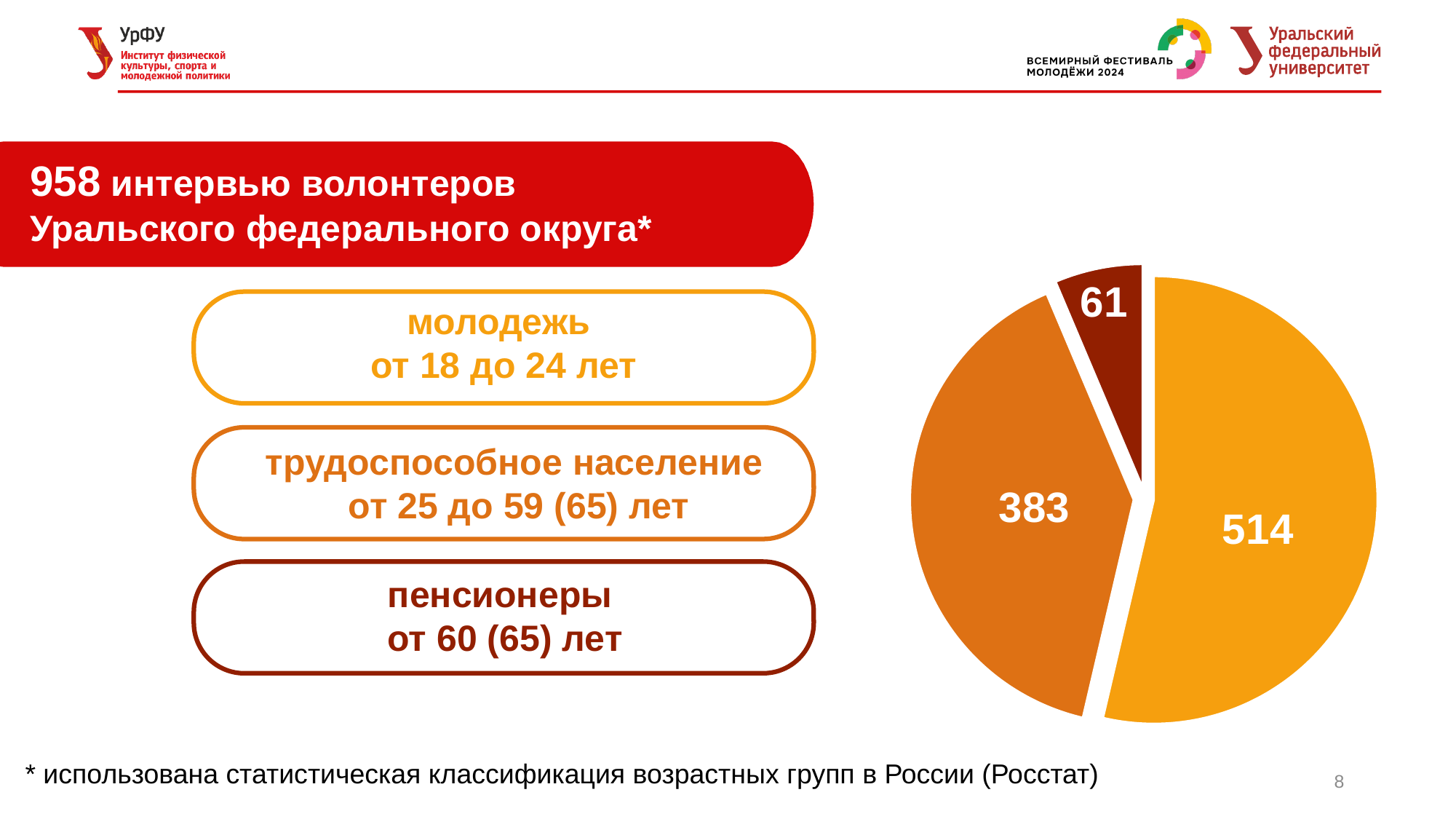
What is the value for молодежь от 18 до 24 лет in the pie chart? 514 Which age group has the largest slice in the pie chart? молодежь от 18 до 24 лет What is the total of all three slices in the pie chart? 958 What is the value for трудоспособное население от 25 до 59 (65) лет in the pie chart? 383 What colour is the slice for пенсионеры от 60 (65) лет? dark red What kind of chart is shown on the slide? pie chart How many slices does the pie chart have? 3 What is the value for пенсионеры от 60 (65) лет in the pie chart? 61 Which is larger: the slice for трудоспособное население or the slice for пенсионеры? трудоспособное население What is the difference between the values for молодежь (514) and трудоспособное население (383)? 131 Which age group has the smallest slice in the pie chart? пенсионеры от 60 (65) лет What is the difference between the values for трудоспособное население (383) and пенсионеры (61)? 322